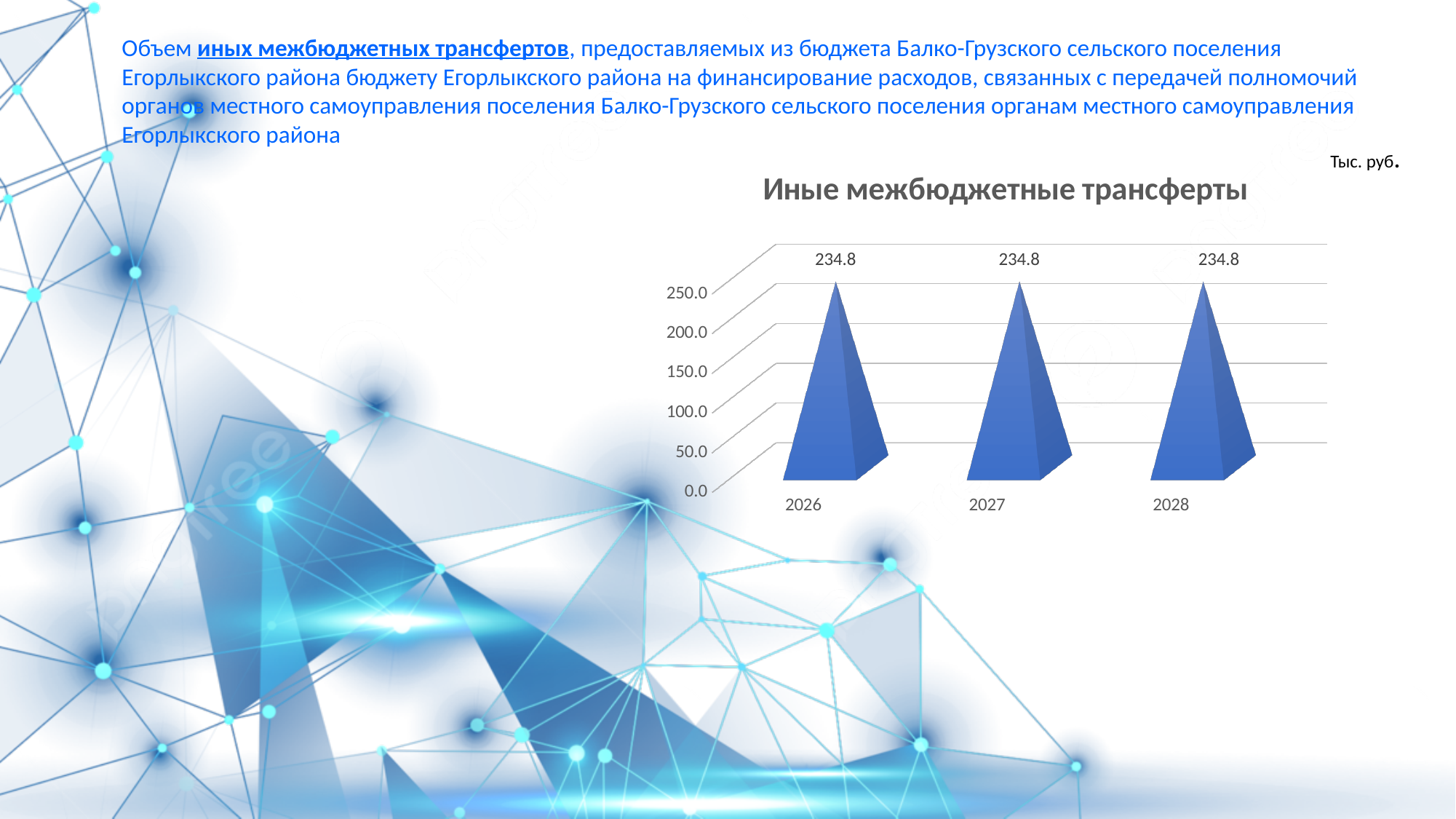
What is the value for 2027 in the chart? 234.8 Do the values rise, fall, or stay the same from 2026 to 2028? Stay the same Which year is the first category on the x axis of the chart? 2026 What is the title of the chart? Иные межбюджетные трансферты What is the value for 2026 in the chart? 234.8 In what units are the chart values given, according to the label above the chart? Тыс. руб. What kind of chart is shown on the slide? Bar chart How many categories (years) are shown on the x axis of the chart? 3 What is the difference between the values for 2028 and 2026? 0.0 Is the value for 2026 greater or less than 250.0? less What is the value for 2028 in the chart? 234.8 Is the value for 2027 greater or less than 200.0? greater